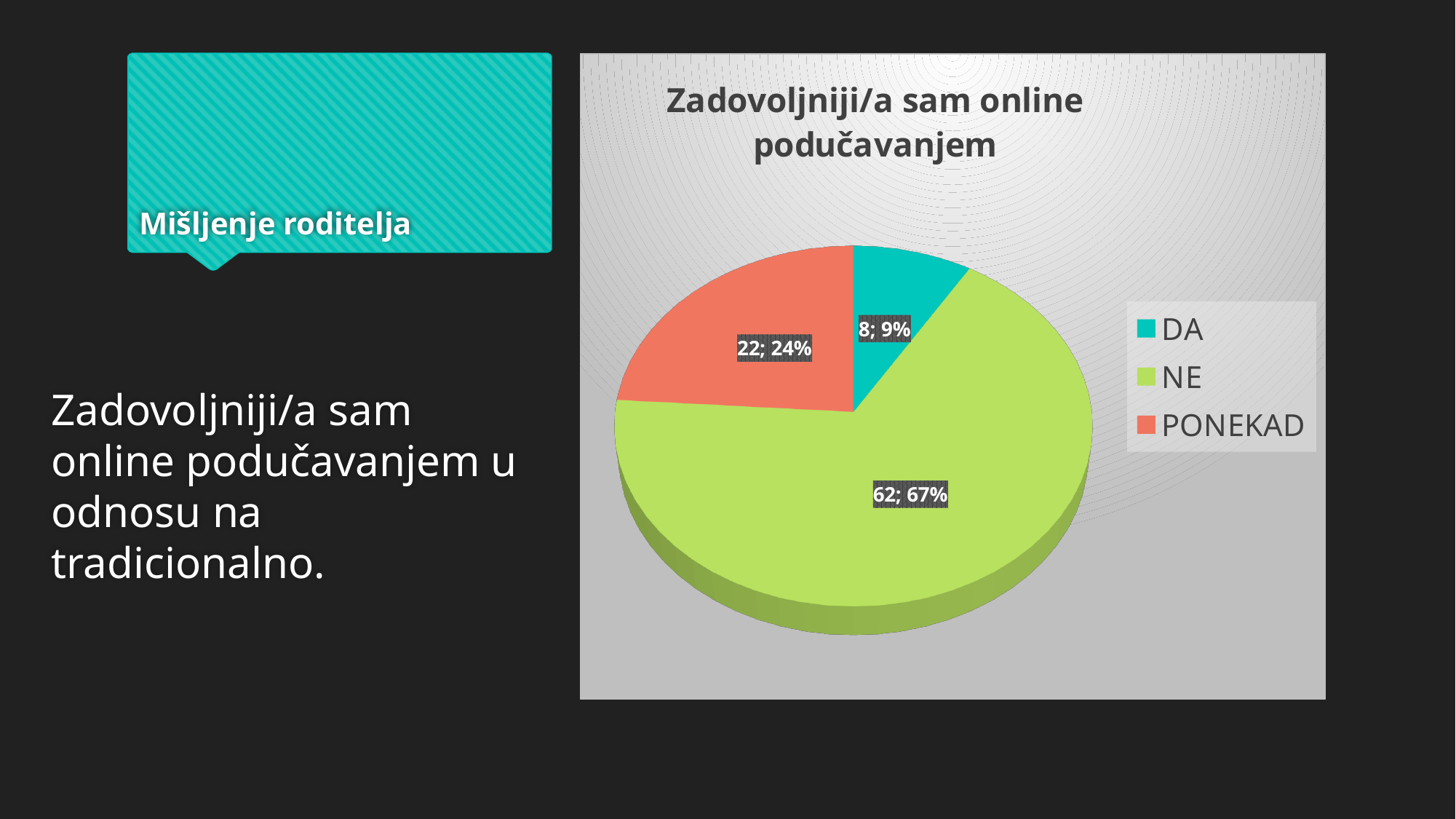
What is the count for the PONEKAD slice? 22 What share of the pie does the NE slice represent? 67% How many entries does the legend list? 3 How many slices does the pie chart have? 3 What type of chart is shown on the slide? pie chart Which category has the smallest slice? DA What is the difference between the counts for NE and PONEKAD? 40 What share of the pie does the PONEKAD slice represent? 24% Which category has the largest slice? NE What is the count for the NE slice? 62 What is the count for the DA slice? 8 What is the title of the chart? Zadovoljniji/a sam online podučavanjem